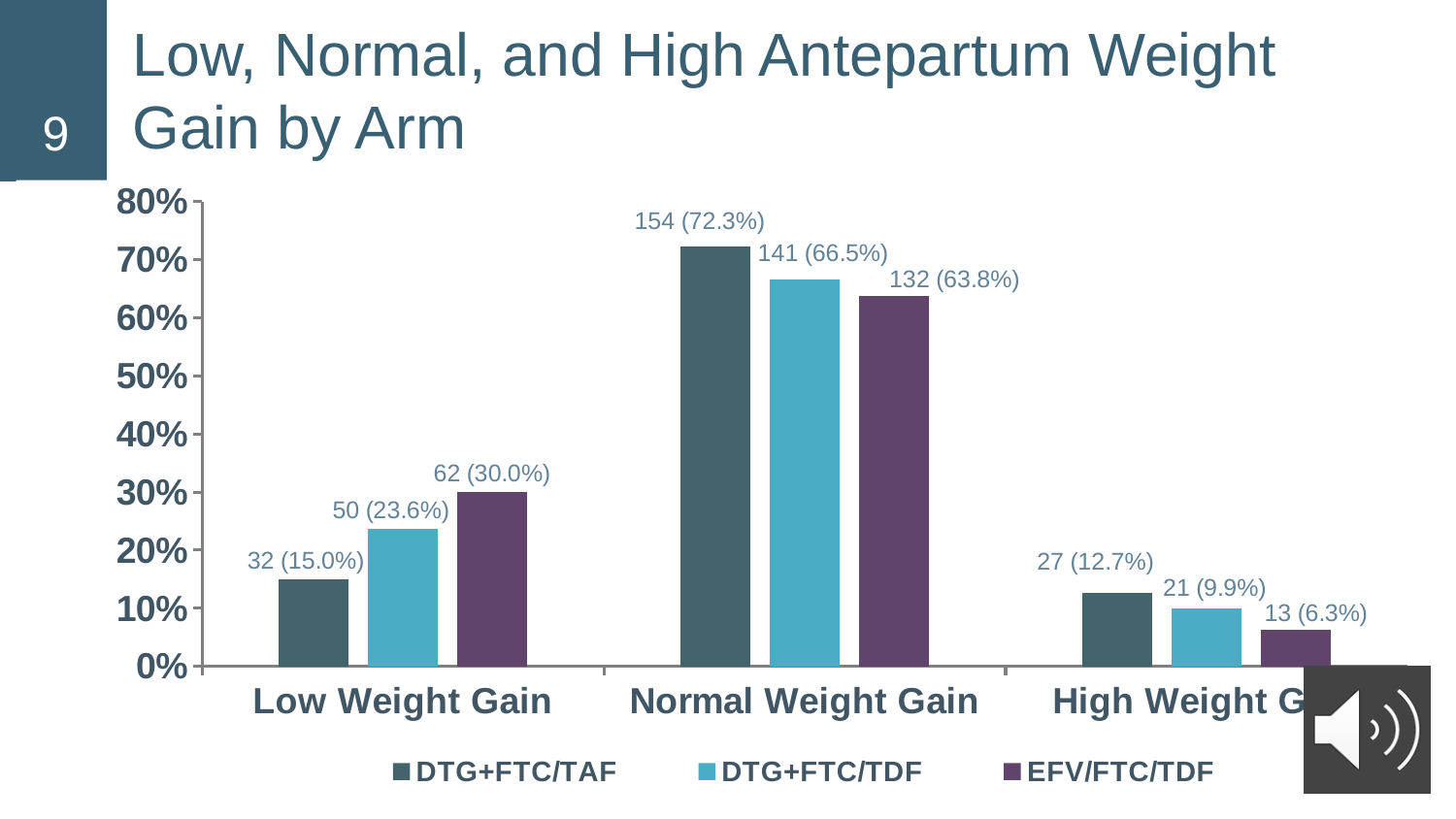
How many weight gain categories are shown on the x axis? 3 What is the data label for EFV/FTC/TDF in the Low Weight Gain category? 62 (30.0%) What is the data label for DTG+FTC/TDF in the High Weight Gain category? 21 (9.9%) Which arm has the lowest percentage in the Low Weight Gain category? DTG+FTC/TAF What is the difference in percentage points between DTG+FTC/TAF and EFV/FTC/TDF in the Normal Weight Gain category? 8.5 percentage points What kind of chart is shown on the slide? Bar chart Which arm has the lowest percentage in the High Weight Gain category? EFV/FTC/TDF In the Low Weight Gain category, which is larger: the percentage for DTG+FTC/TDF or for EFV/FTC/TDF? EFV/FTC/TDF What is the data label for DTG+FTC/TAF in the Normal Weight Gain category? 154 (72.3%) Which arm has the highest percentage in the Normal Weight Gain category? DTG+FTC/TAF How many series does the legend list? 3 Is the value for DTG+FTC/TDF in the Normal Weight Gain category greater or less than 60%? greater